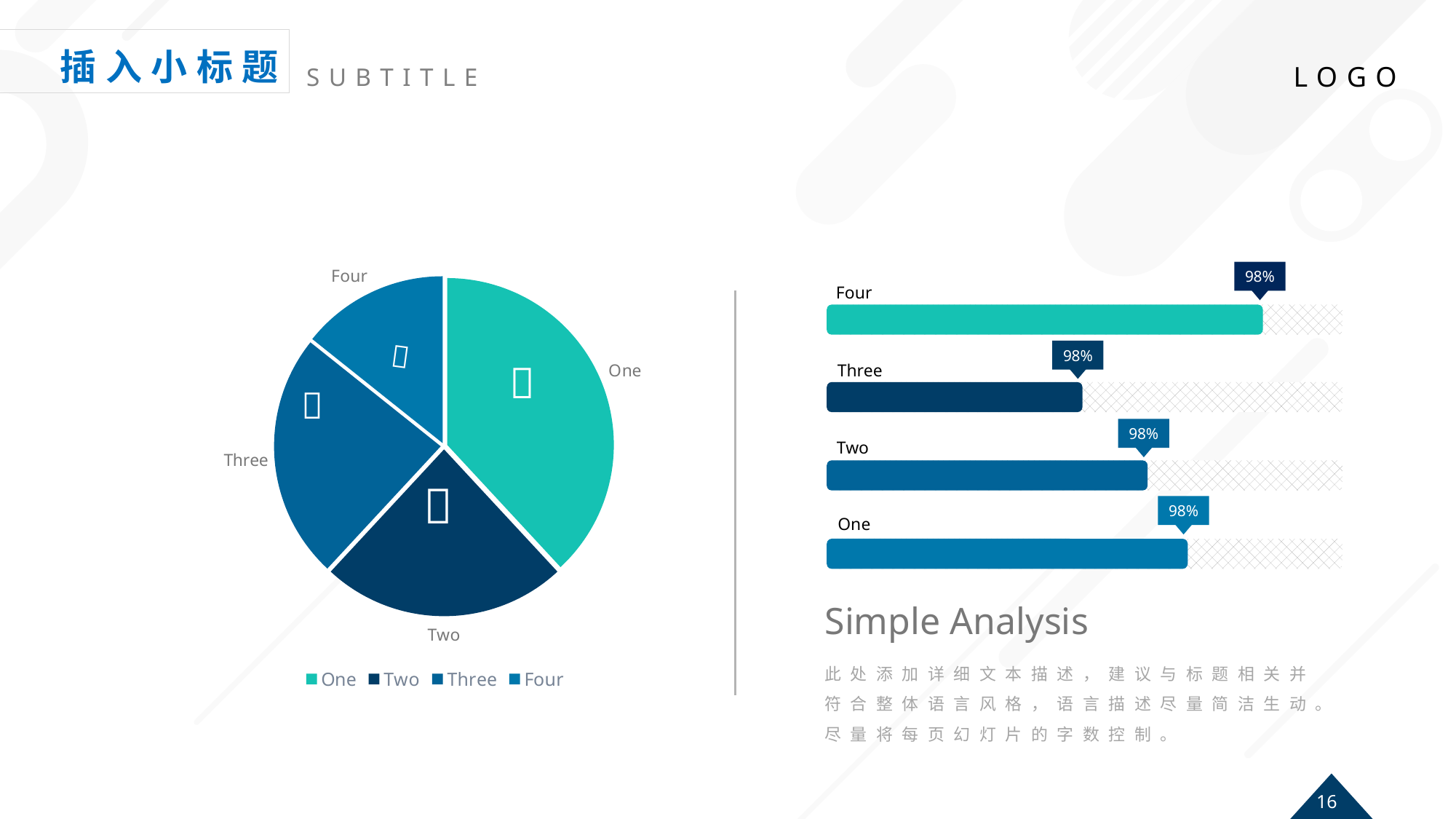
In the pie chart on the left, which slice is larger, One or Four? One How many entries does the legend of the pie chart on the left list? 4 How many slices does the pie chart on the left have? 4 What are the legend entries of the pie chart on the left, in order? One, Two, Three, Four In the pie chart on the left, which category has the largest slice? One What kind of chart is shown on the left side of the slide? pie chart In the pie chart on the left, which category has the smallest slice? Four What kind of chart is shown on the right side of the slide? bar chart In the bar chart on the right, which category is listed at the top? Four In the bar chart on the right, what value is labelled for One? 98% In the bar chart on the right, what value is labelled for Four? 98% How many bars does the bar chart on the right have? 4